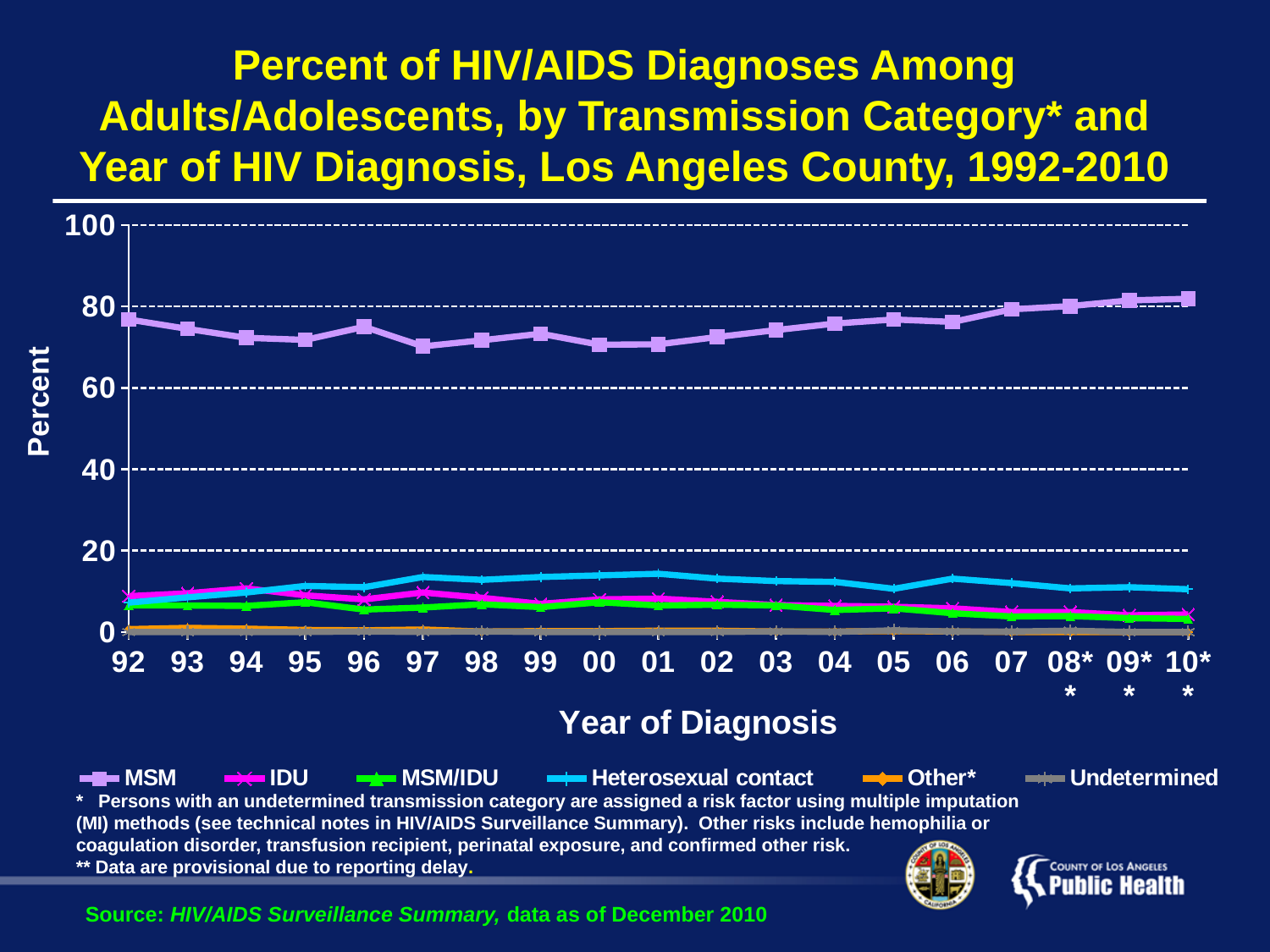
How many series does the legend list? 6 Which is larger in 92, the value for MSM or the value for IDU? MSM Which transmission category has the highest percentage across all years? MSM What is the label of the y axis? Percent Is the value for Heterosexual contact in 01 greater or less than 20? less Is the value for MSM in 92 greater or less than 60? greater Is the value for IDU in 10* greater or less than 20? less What is the label of the x axis? Year of Diagnosis How many years of diagnosis are plotted along the x axis? 19 Does the MSM line rise or fall from 05 to 10*? rises What kind of chart is shown on the slide? line chart Which is larger in 00, the value for Heterosexual contact or the value for Other*? Heterosexual contact